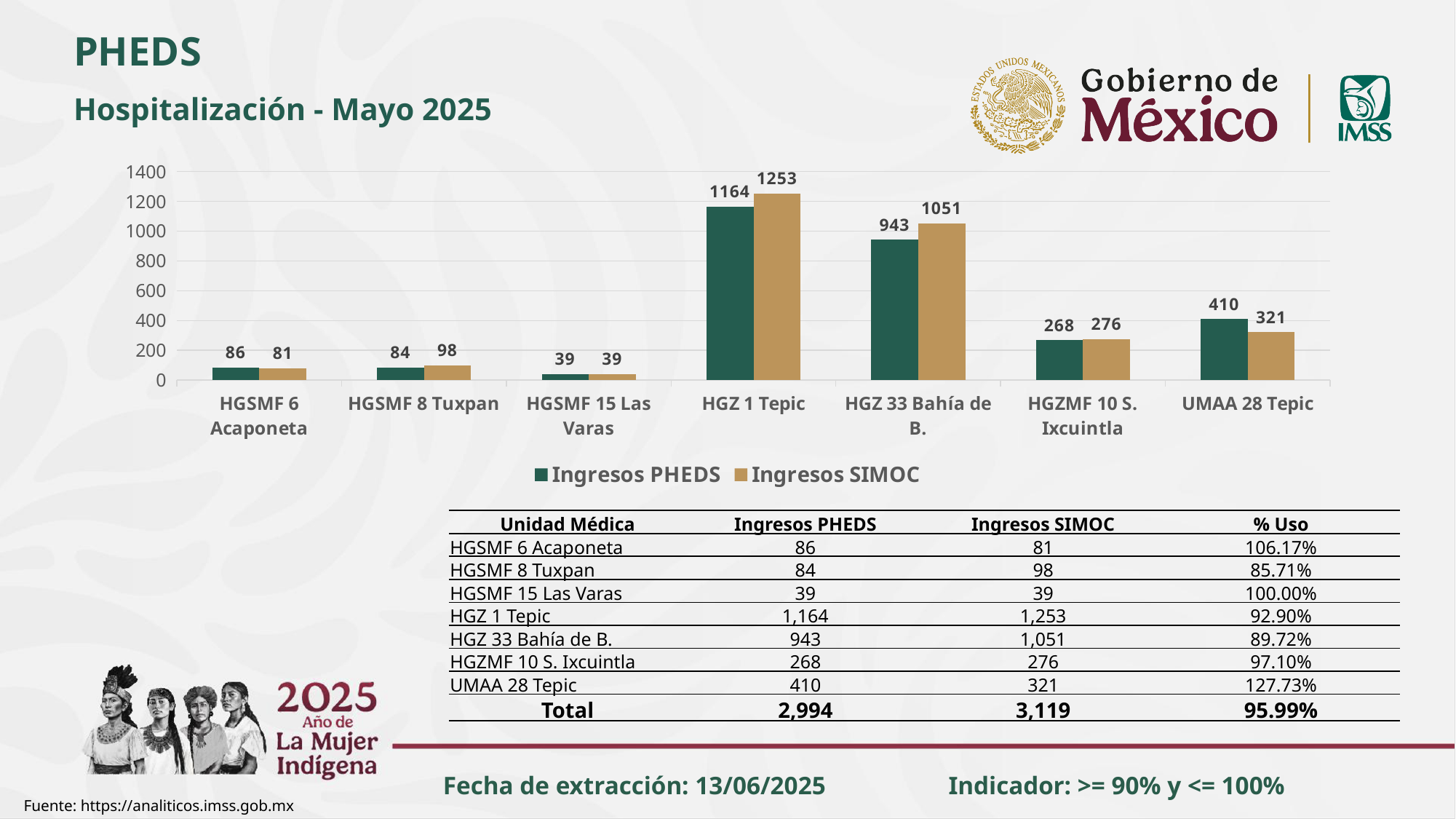
Which unit has the lowest Ingresos SIMOC value? HGSMF 15 Las Varas What is the Ingresos SIMOC value for UMAA 28 Tepic? 321 What is the Ingresos SIMOC value for HGZ 33 Bahía de B.? 1051 What is the difference between Ingresos SIMOC and Ingresos PHEDS for HGZ 1 Tepic? 89 How many medical units are shown on the x axis of the chart? 7 Which unit has the highest Ingresos PHEDS value? HGZ 1 Tepic What kind of chart is shown on the slide? Bar chart What are the two series named in the chart legend? Ingresos PHEDS and Ingresos SIMOC For UMAA 28 Tepic, which is larger: Ingresos PHEDS or Ingresos SIMOC? Ingresos PHEDS How many series does the chart legend list? 2 Is the Ingresos PHEDS value for HGZ 33 Bahía de B. greater or less than 800? greater What is the Ingresos PHEDS value for HGZ 1 Tepic? 1164